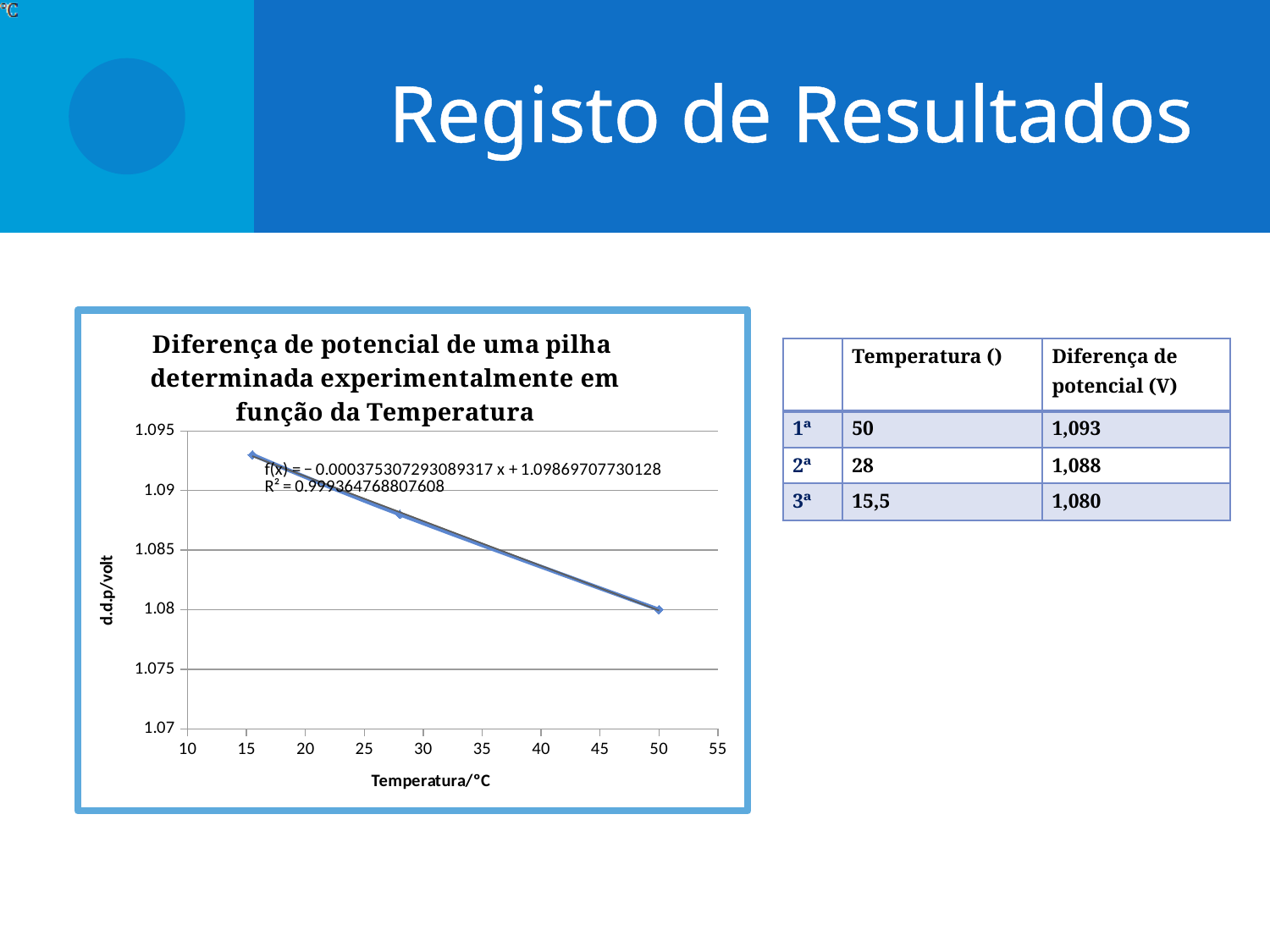
Which plotted point has the highest d.d.p value, the one at 15 °C, 28 °C or 50 °C? 15 °C Is the d.d.p value of the point plotted at about 28 °C greater or less than 1.085? greater Which plotted point has the lowest d.d.p value, the one at 15 °C, 28 °C or 50 °C? 50 °C Which point has a larger d.d.p value, the one at 28 °C or the one at 50 °C? 28 °C Do the plotted values rise or fall as temperature increases along the x axis? Fall What is the label of the y axis of the chart? d.d.p/volt What is the d.d.p value of the point plotted at 50 °C? 1.08 What is the R² value shown on the chart? 0.999364768807608 How many data points are plotted on the chart? 3 Is the d.d.p value of the point plotted at about 15 °C greater or less than 1.09? greater What kind of chart is shown on the slide? Scatter chart with a trendline